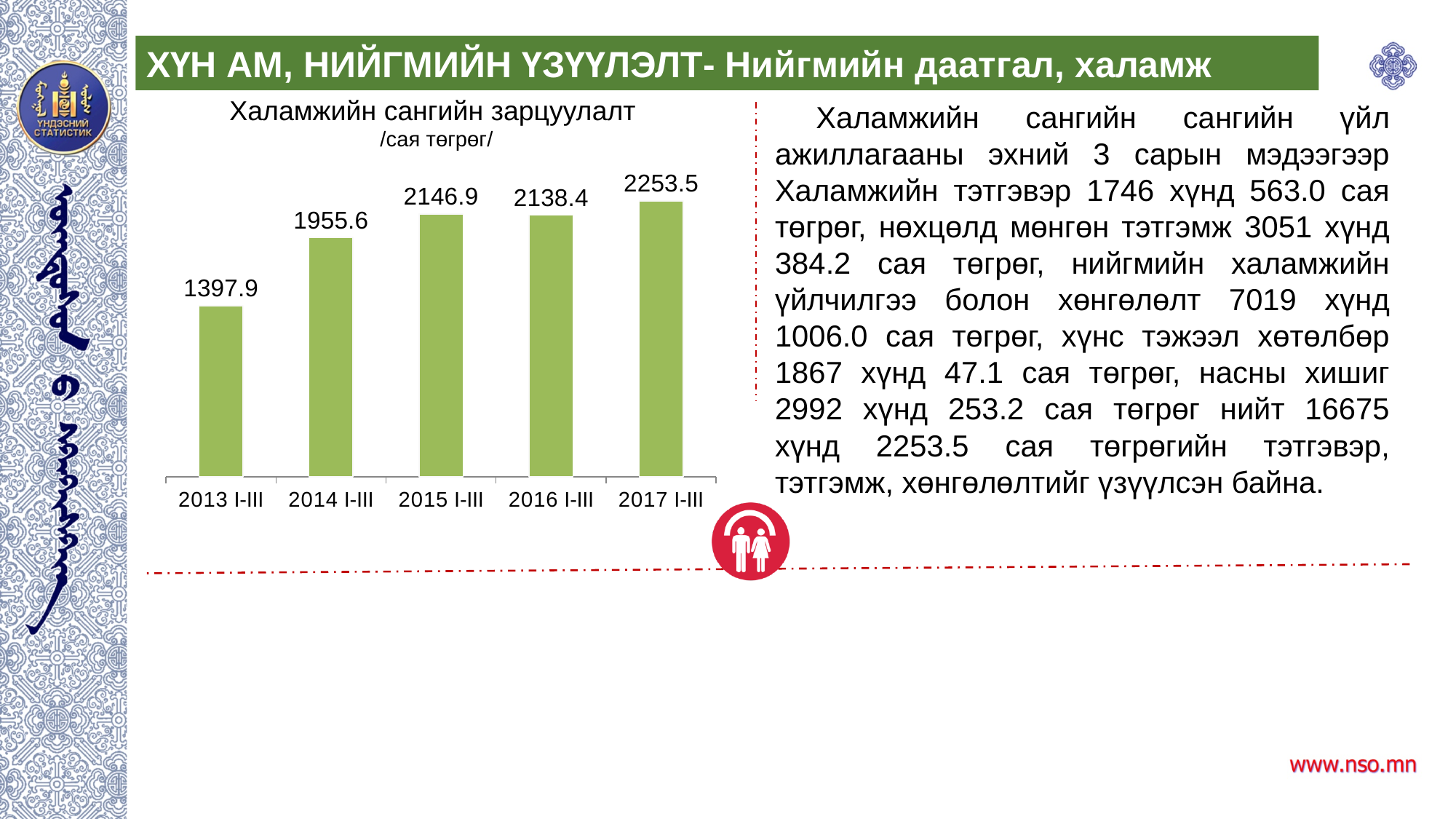
What unit is given under the chart title? сая төгрөг Which is larger, the value for 2014 I-III or the value for 2013 I-III? 2014 I-III What is the title of the chart? Халамжийн сангийн зарцуулалт Which period has the highest value in the chart? 2017 I-III What is the value for 2017 I-III in the chart? 2253.5 What is the value for 2013 I-III in the chart? 1397.9 How many periods (bars) are shown in the chart? 5 Which period has the lowest value in the chart? 2013 I-III What is the difference between the values for 2017 I-III and 2013 I-III? 855.6 What kind of chart is shown on the slide? Bar chart What is the value for 2015 I-III in the chart? 2146.9 What is the difference between the values for 2015 I-III and 2016 I-III? 8.5